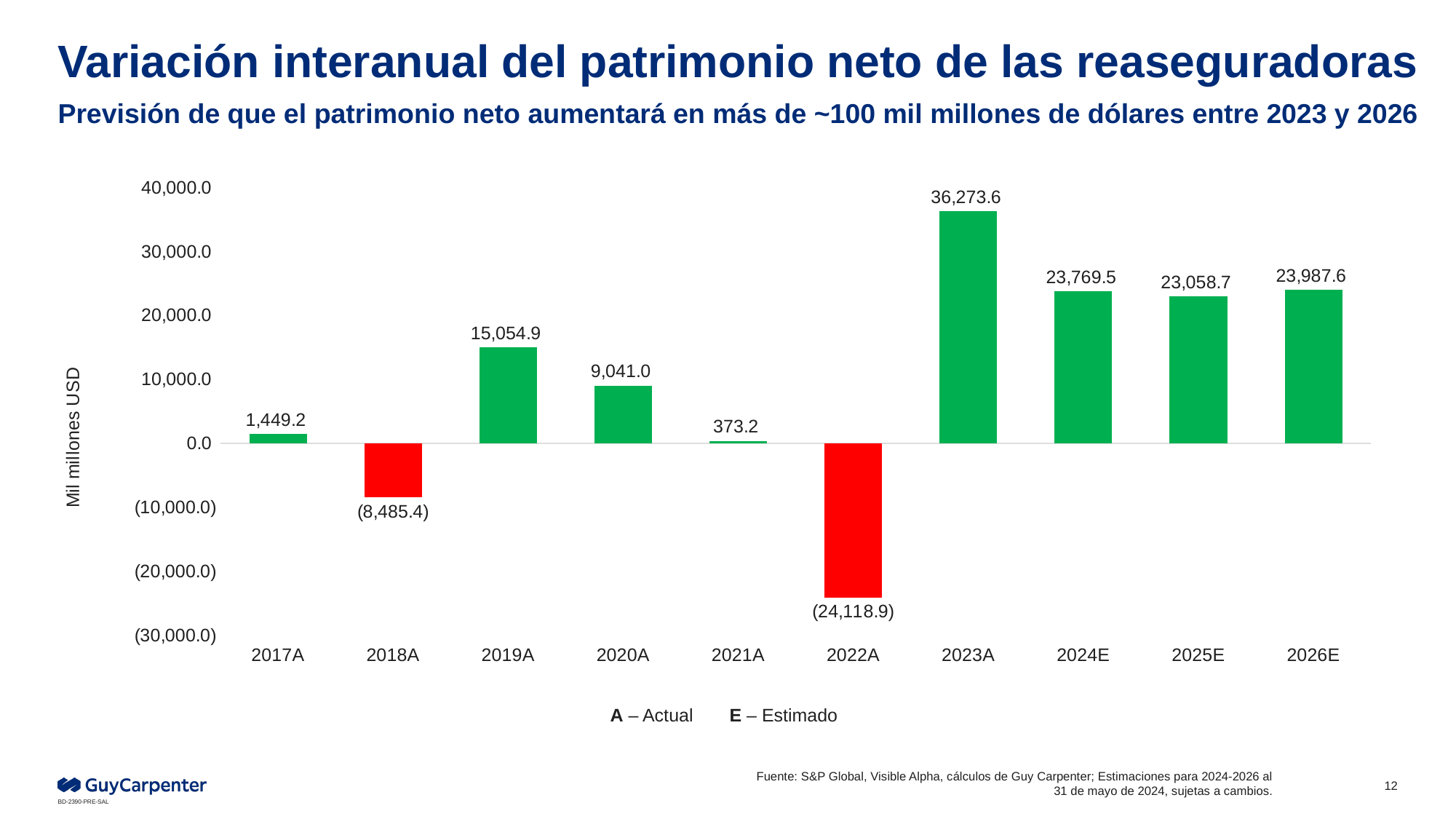
What is the value for 2022A? (24,118.9) What kind of chart is shown on the slide? bar chart Which year has the highest value? 2023A Is the value for 2023A greater or less than 30,000.0? greater What is the difference between the values for 2019A and 2020A? 6,013.9 Which is larger, the value for 2024E or the value for 2025E? 2024E What is the value for 2023A? 36,273.6 What is the label on the vertical axis? Mil millones USD Which year has the lowest value? 2022A How many years are shown on the x axis? 10 What is the difference between the values for 2023A and 2024E? 12,504.1 What is the value for 2021A? 373.2